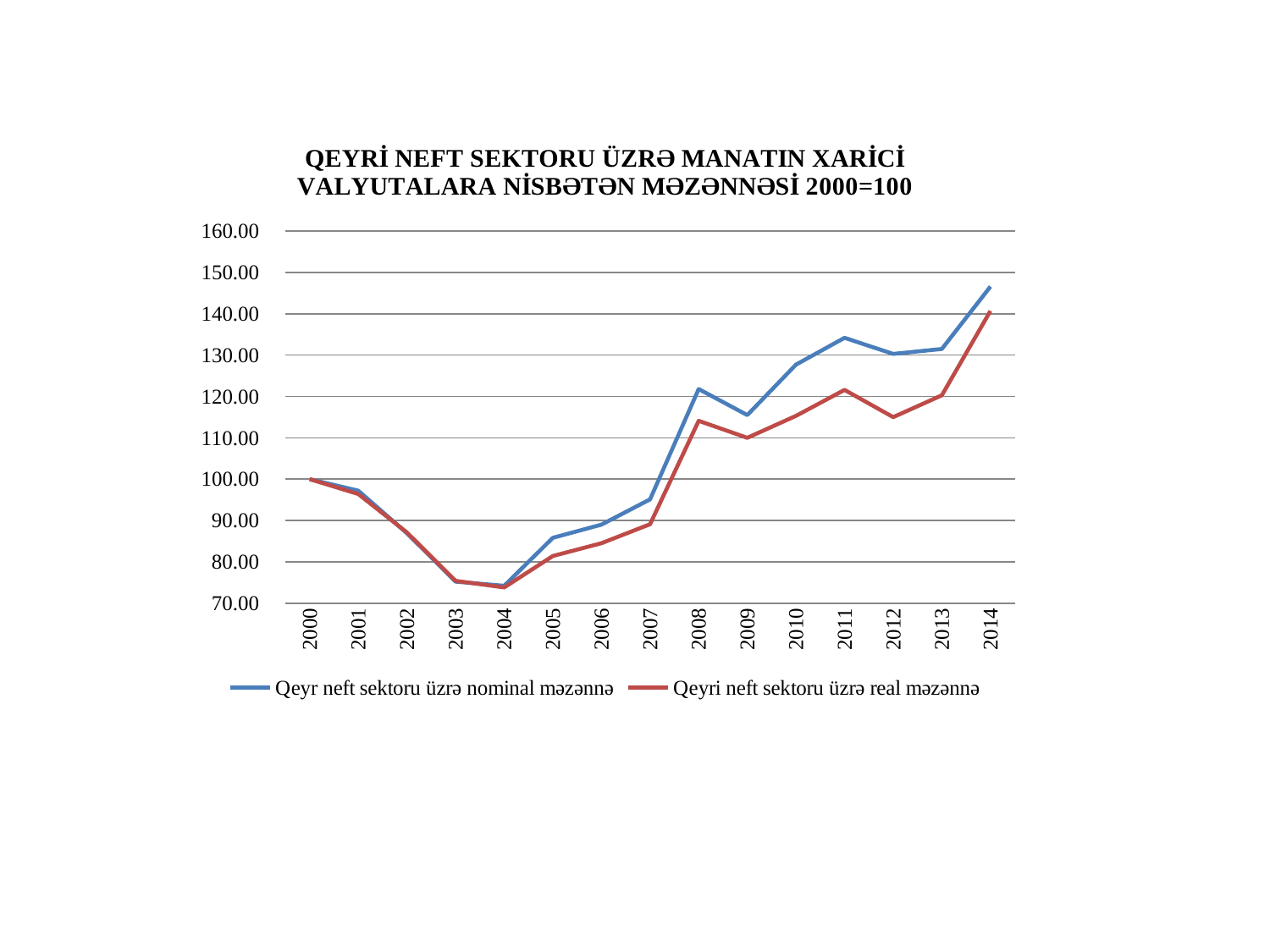
In which year does the real series (Qeyri neft sektoru üzrə real məzənnə) reach its highest value? 2014 Do the values of the nominal series rise or fall from 2000 to 2004? fall Is the value of the real series in 2011 greater or less than 130? less How many years are plotted along the x axis? 15 Is the value of the nominal series in 2011 greater or less than 130? greater In which year does the nominal series (Qeyr neft sektoru üzrə nominal məzənnə) reach its highest value? 2014 Is the value of the real series in 2003 greater or less than 80? less How many series does the legend list? 2 What is the value of the nominal series (Qeyr neft sektoru üzrə nominal məzənnə) in 2000? 100.00 In 2008, which series has the larger value, the nominal series or the real series? nominal series What kind of chart is shown on the slide? line chart